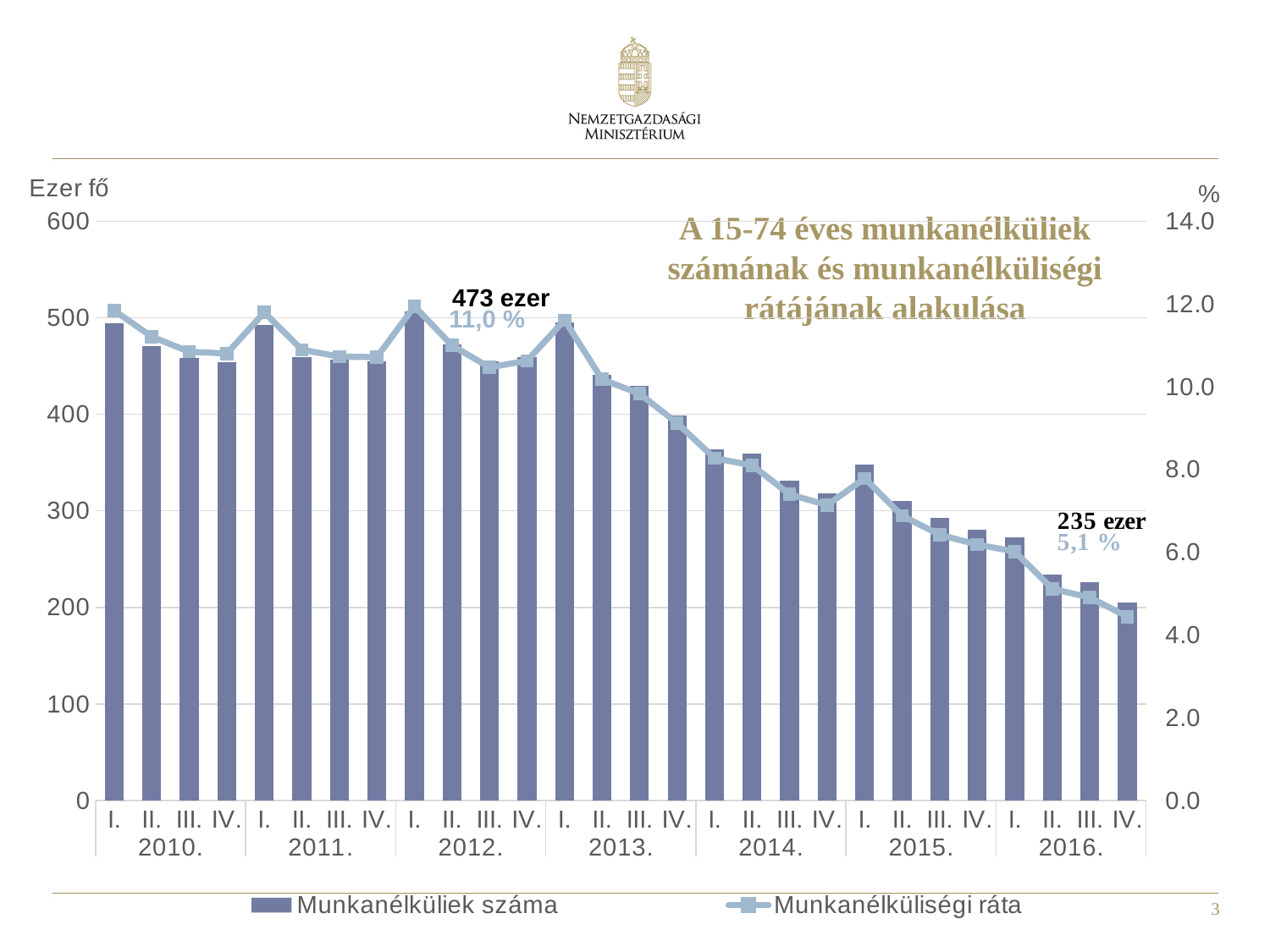
Is the Munkanélküliségi ráta value for 2016. IV. greater or less than 6.0? less What unit is shown on the left vertical axis? Ezer fő Which is larger, the Munkanélküliek száma bar for 2013. I. or for 2014. I.? 2013. I. Which series is drawn as a line in the chart? Munkanélküliségi ráta Is the Munkanélküliek száma bar for 2016. IV. greater or less than 300? less What kind of chart is shown on the slide? A combined bar and line chart How many series does the legend list? 2 Which quarter has the lowest number of unemployed (Munkanélküliek száma)? 2016. IV. Is the Munkanélküliek száma bar for 2010. I. greater or less than 400? greater How many quarterly bars are plotted in the chart? 28 Overall, do the bars for Munkanélküliek száma rise or fall from 2010 to 2016? Fall What 'ezer' value is labelled near the 2016 bars? 235 ezer